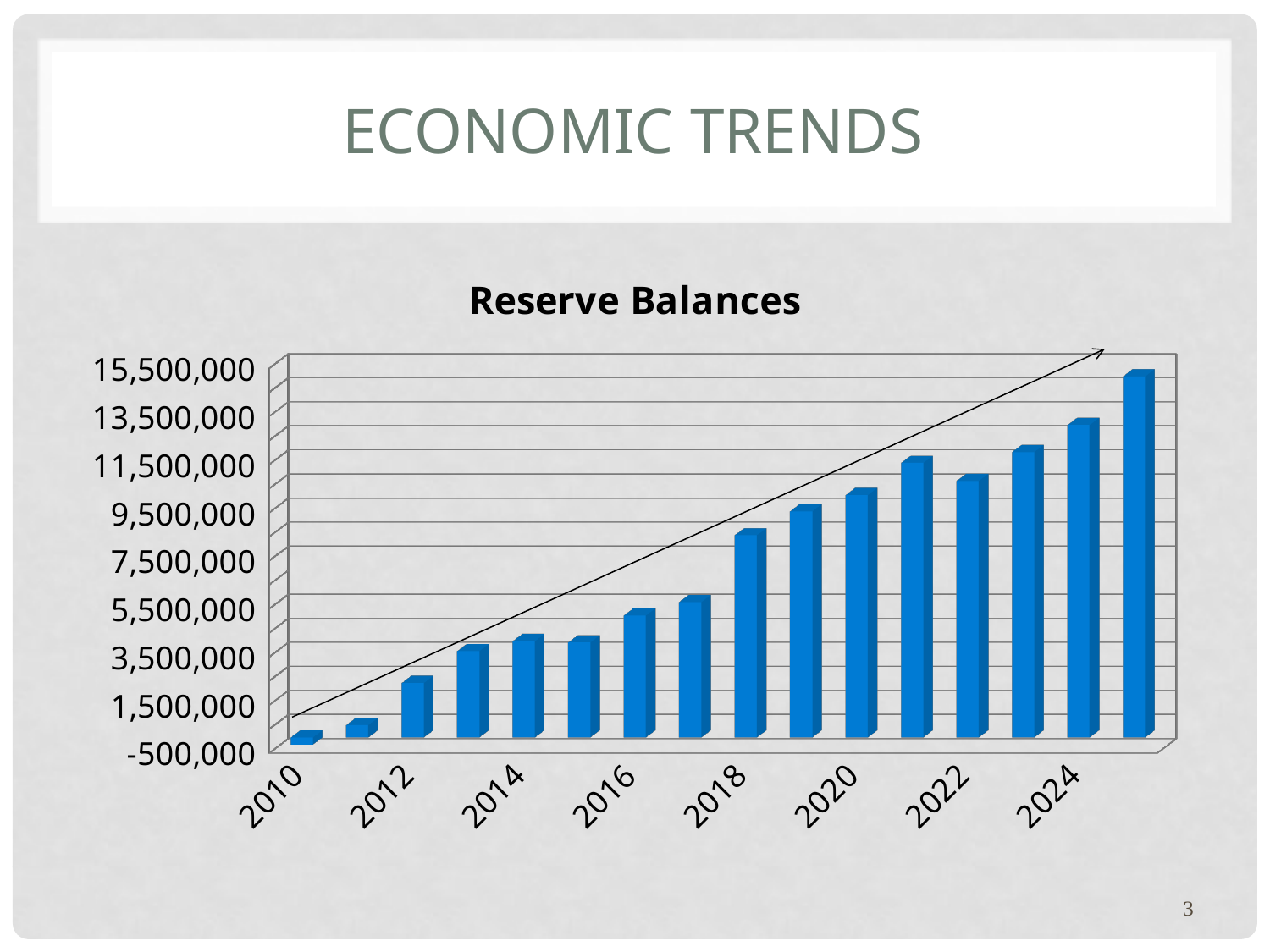
Which year has the larger reserve balance, 2020 or 2022? 2022 What kind of chart is shown on the slide? bar chart Which labeled year has the lowest reserve balance? 2010 Which year has the larger reserve balance, 2012 or 2014? 2014 Is the reserve balance for 2024 greater or less than 11,500,000? greater What is the title of the chart? Reserve Balances How many bars are plotted in the Reserve Balances chart? 16 Do the reserve balances generally rise or fall from 2010 to the end of the chart? rise Is the reserve balance for 2012 greater or less than 1,500,000? greater Is the reserve balance for 2018 greater or less than 7,500,000? greater